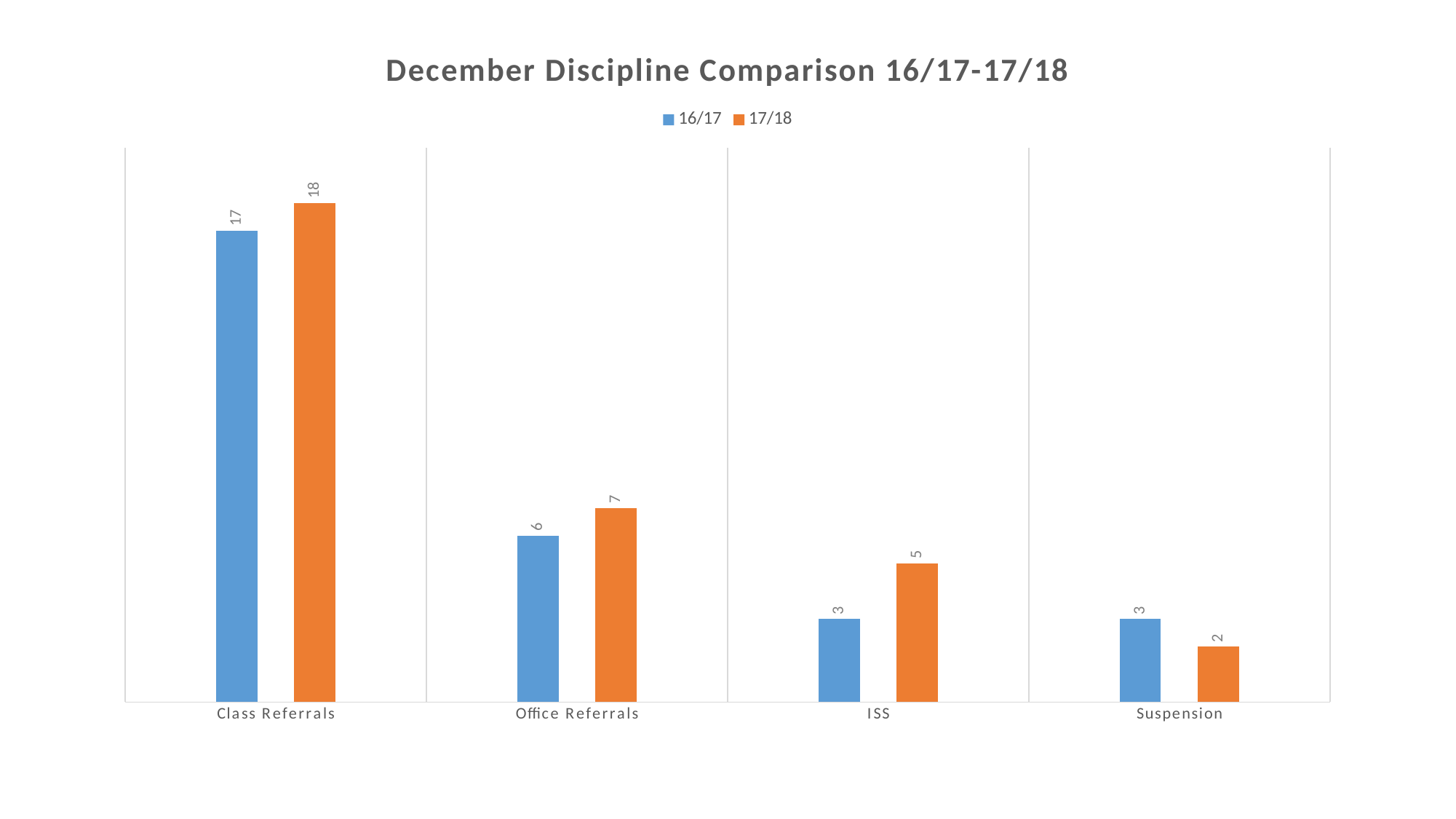
What is the title of the chart? December Discipline Comparison 16/17-17/18 What is the 17/18 value for ISS? 5 What is the difference between the 17/18 and 16/17 values for ISS? 2 Which category has the highest 17/18 value? Class Referrals What is the 17/18 value for Suspension? 2 How many series does the legend list? 2 How many categories are shown on the x axis? 4 What is the 17/18 value for Office Referrals? 7 What is the 16/17 value for Class Referrals? 17 For Suspension, which series has the larger value, 16/17 or 17/18? 16/17 Which category has the lowest 17/18 value? Suspension What kind of chart is shown on the slide? Bar chart